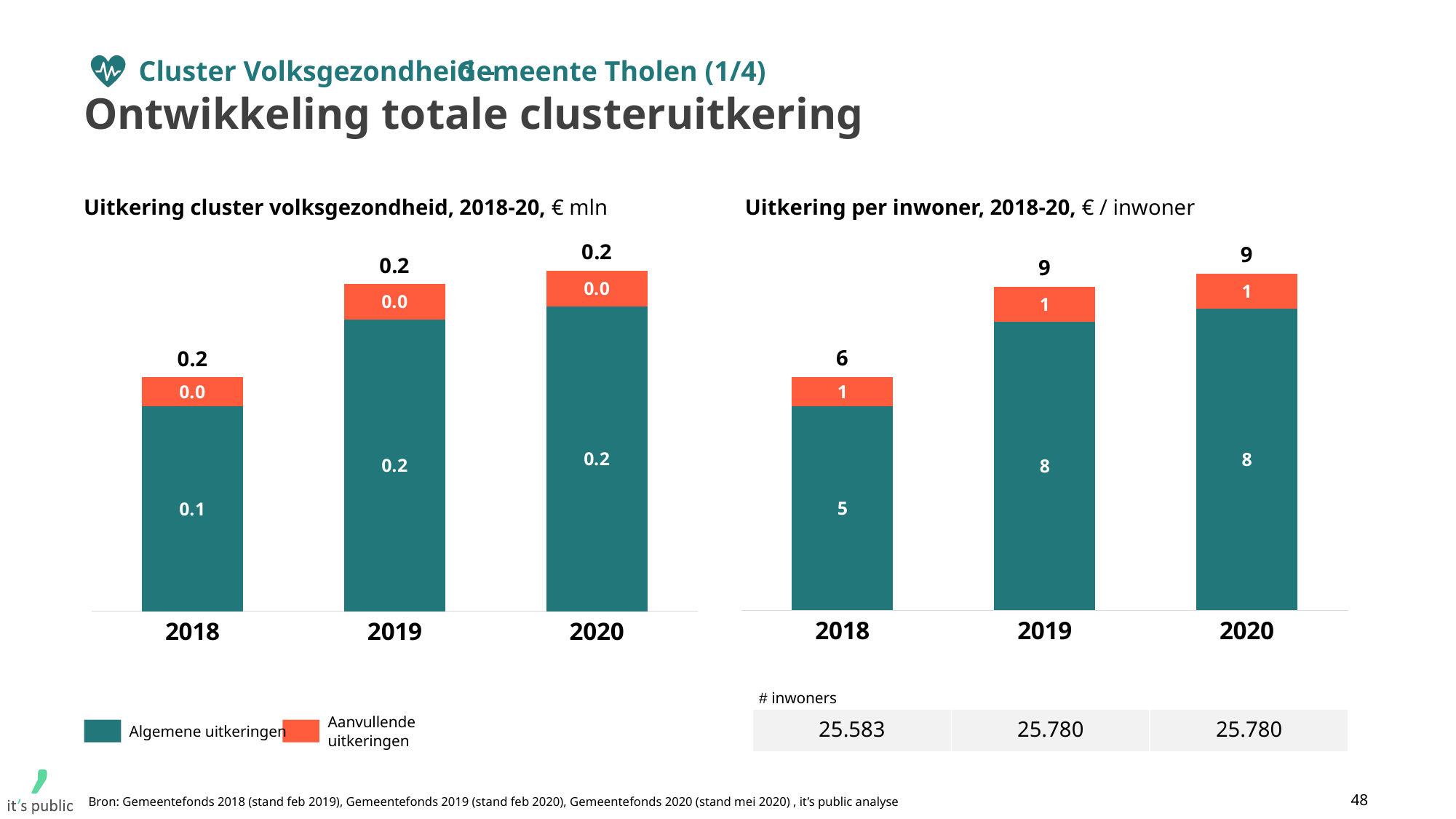
How many years are shown on the x axis of the chart 'Uitkering cluster volksgezondheid, 2018-20'? 3 In the chart 'Uitkering per inwoner, 2018-20', what is the value of Algemene uitkeringen for 2018? 5 How many series does the legend list for the charts on this slide? 2 What is the unit given in the title of the left chart, 'Uitkering cluster volksgezondheid, 2018-20'? € mln In the chart 'Uitkering per inwoner, 2018-20', is the Algemene uitkeringen value larger in 2018 or in 2020? 2020 In the chart 'Uitkering cluster volksgezondheid, 2018-20', what is the value of Aanvullende uitkeringen for 2020? 0.0 In the chart 'Uitkering per inwoner, 2018-20', what is the total value shown above the bar for 2019? 9 In the chart 'Uitkering per inwoner, 2018-20', which year has the lowest total? 2018 In the chart 'Uitkering per inwoner, 2018-20', what is the difference in Algemene uitkeringen between 2019 and 2018? 3 In the chart 'Uitkering per inwoner, 2018-20', does the total value rise or fall from 2018 to 2019? Rise What kind of chart is 'Uitkering per inwoner, 2018-20'? Stacked bar chart In the chart 'Uitkering cluster volksgezondheid, 2018-20', what is the value of Algemene uitkeringen for 2018? 0.1